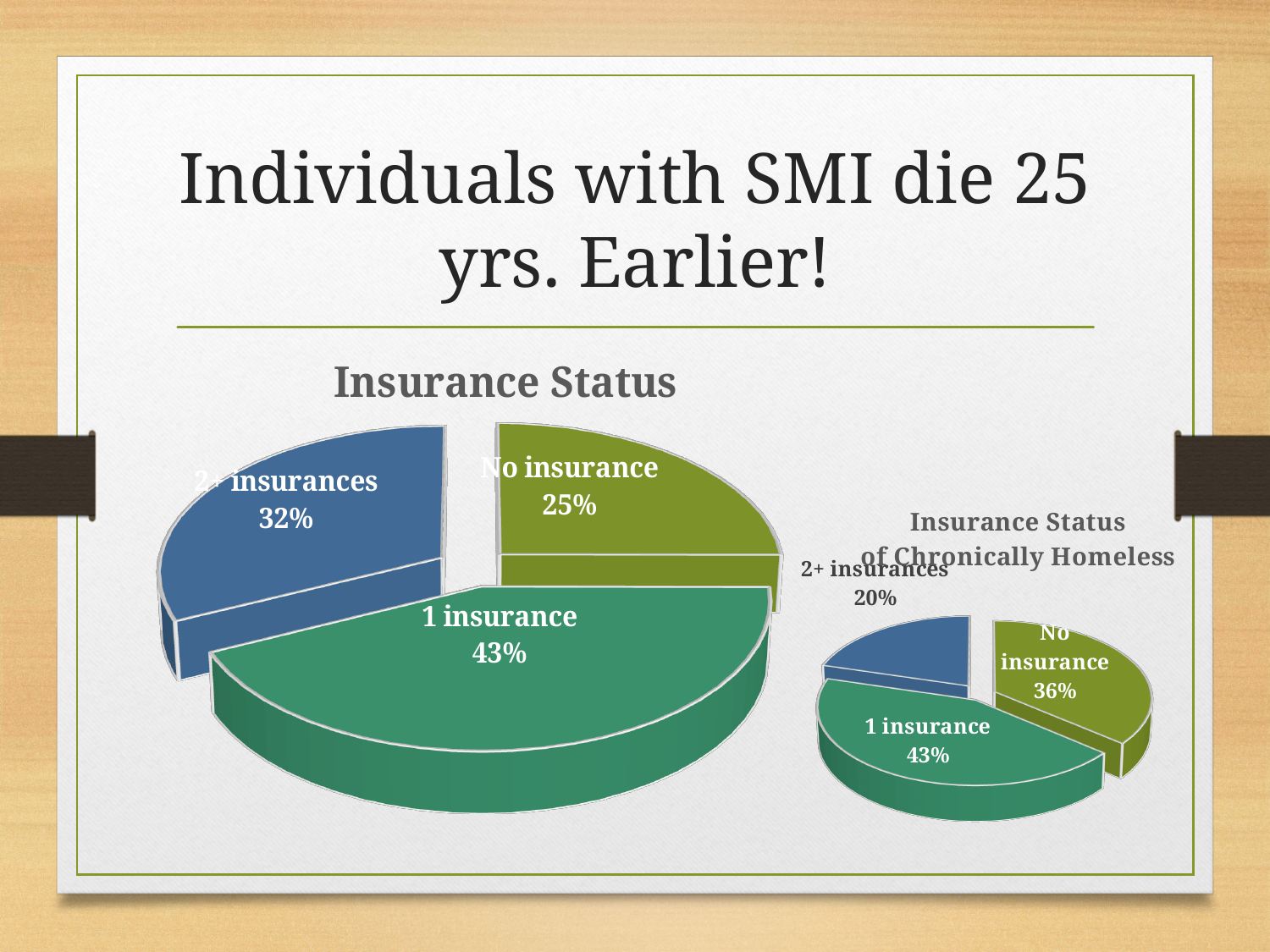
In the 'Insurance Status' chart, which category has the smallest slice? No insurance In the 'Insurance Status of Chronically Homeless' chart, what share is labelled for '2+ insurances'? 20% In the 'Insurance Status of Chronically Homeless' chart, which category has the smallest slice? 2+ insurances How many slices does the 'Insurance Status' chart have? 3 In the 'Insurance Status' chart, which category has the largest slice? 1 insurance What kind of chart is the 'Insurance Status of Chronically Homeless' chart? Pie chart In the 'Insurance Status' chart, what share is labelled for 'No insurance'? 25% In the 'Insurance Status' chart, what share is labelled for '1 insurance'? 43% In the 'Insurance Status' chart, what is the difference in percentage points between '1 insurance' and 'No insurance'? 18 In the 'Insurance Status of Chronically Homeless' chart, which is larger: 'No insurance' or '2+ insurances'? No insurance In the 'Insurance Status' chart, what share is labelled for '2+ insurances'? 32% In the 'Insurance Status of Chronically Homeless' chart, what share is labelled for 'No insurance'? 36%